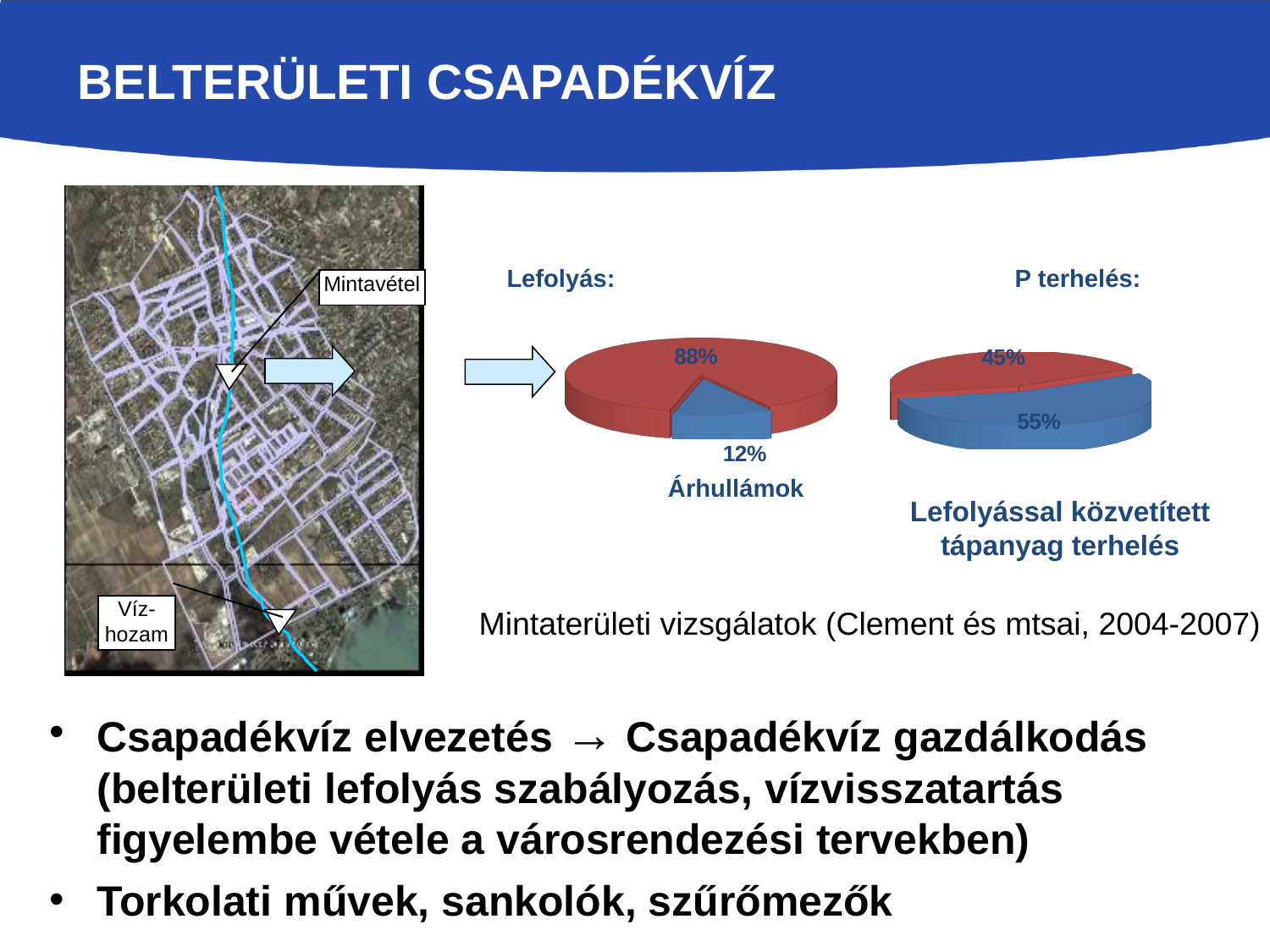
What kind of chart is the "Lefolyás:" chart? Pie chart How many slices does the "P terhelés:" pie chart have? 2 In the "P terhelés:" pie chart, what is the difference in percentage points between the blue and red slices? 10 percentage points In the "P terhelés:" pie chart, what percentage is shown on the red slice? 45% How many slices does the "Lefolyás:" pie chart have? 2 How many pie charts are shown on the slide? 2 In the "P terhelés:" pie chart, what percentage is shown on the blue slice? 55% In the "P terhelés:" pie chart, which slice is larger, the red one or the blue one? The blue one (55%) In the "Lefolyás:" pie chart, what is the difference in percentage points between the larger slice and the "Árhullámok" slice? 76 percentage points What caption appears below the "P terhelés:" pie chart? Lefolyással közvetített tápanyag terhelés In the "Lefolyás:" pie chart, what share is labelled "Árhullámok"? 12% In the "Lefolyás:" pie chart, what percentage is shown on the larger (red) slice? 88%